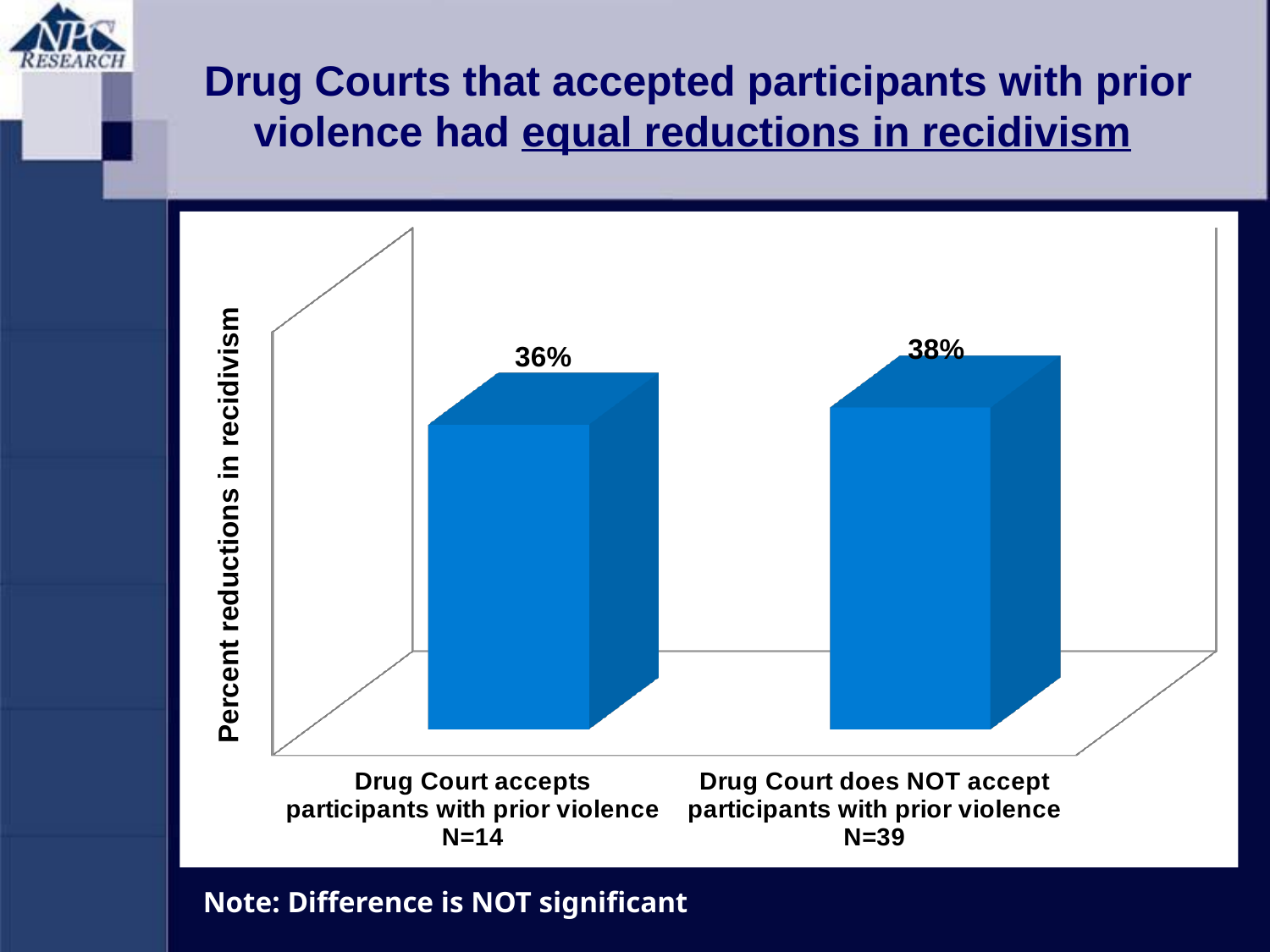
What is the difference in percent reduction in recidivism between the two categories? 2% How many categories are shown in the chart? 2 What is the label of the vertical axis? Percent reductions in recidivism What does the note below the chart say about the difference between the two groups? Difference is NOT significant What is the sample size (N) for Drug Courts that do NOT accept participants with prior violence? N=39 What is the percent reduction in recidivism for Drug Courts that accept participants with prior violence? 36% Which category has the higher percent reduction in recidivism? Drug Court does NOT accept participants with prior violence Is the percent reduction in recidivism larger for Drug Courts that accept participants with prior violence or for those that do NOT? Drug Court does NOT accept participants with prior violence What is the percent reduction in recidivism for Drug Courts that do NOT accept participants with prior violence? 38% Which category has the lower percent reduction in recidivism? Drug Court accepts participants with prior violence What is the sample size (N) for Drug Courts that accept participants with prior violence? N=14 What kind of chart is shown on the slide? Bar chart